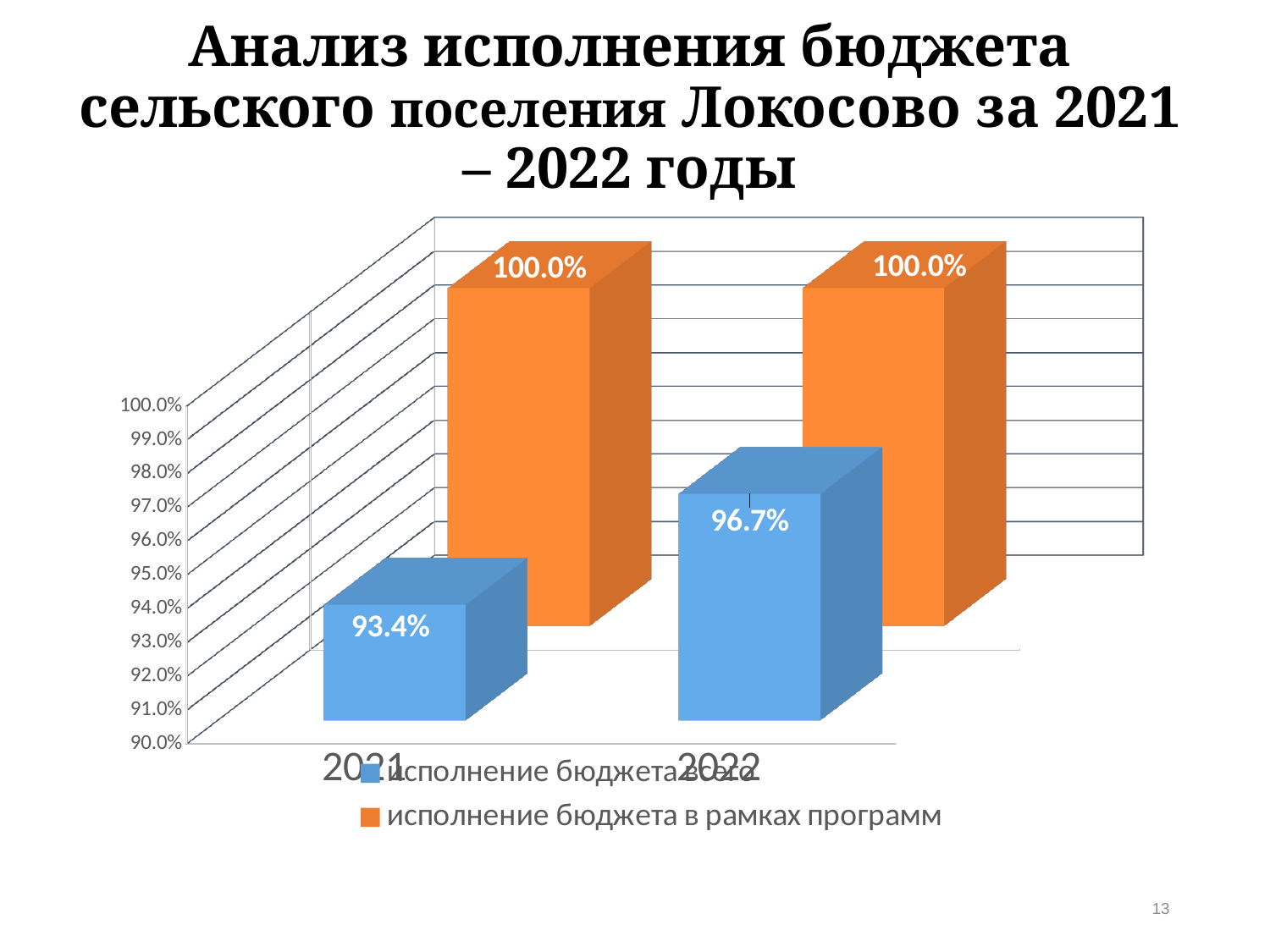
Does the blue series rise or fall from 2021 to 2022? rises What is the difference between "исполнение бюджета в рамках программ" and the blue series in 2021? 6.6% What kind of chart is shown on the slide? bar chart What is the value of the blue series for 2022? 96.7% What is the value of "исполнение бюджета в рамках программ" for 2021? 100.0% Is the value of the blue series for 2021 greater or less than 95.0%? less What is the value of "исполнение бюджета в рамках программ" for 2022? 100.0% How many years (categories) are shown on the x axis? 2 How many series does the legend list? 2 For the blue series, which year has the larger value, 2021 or 2022? 2022 By how much did the blue series increase from 2021 to 2022? 3.3% What is the value of the blue series for 2021? 93.4%